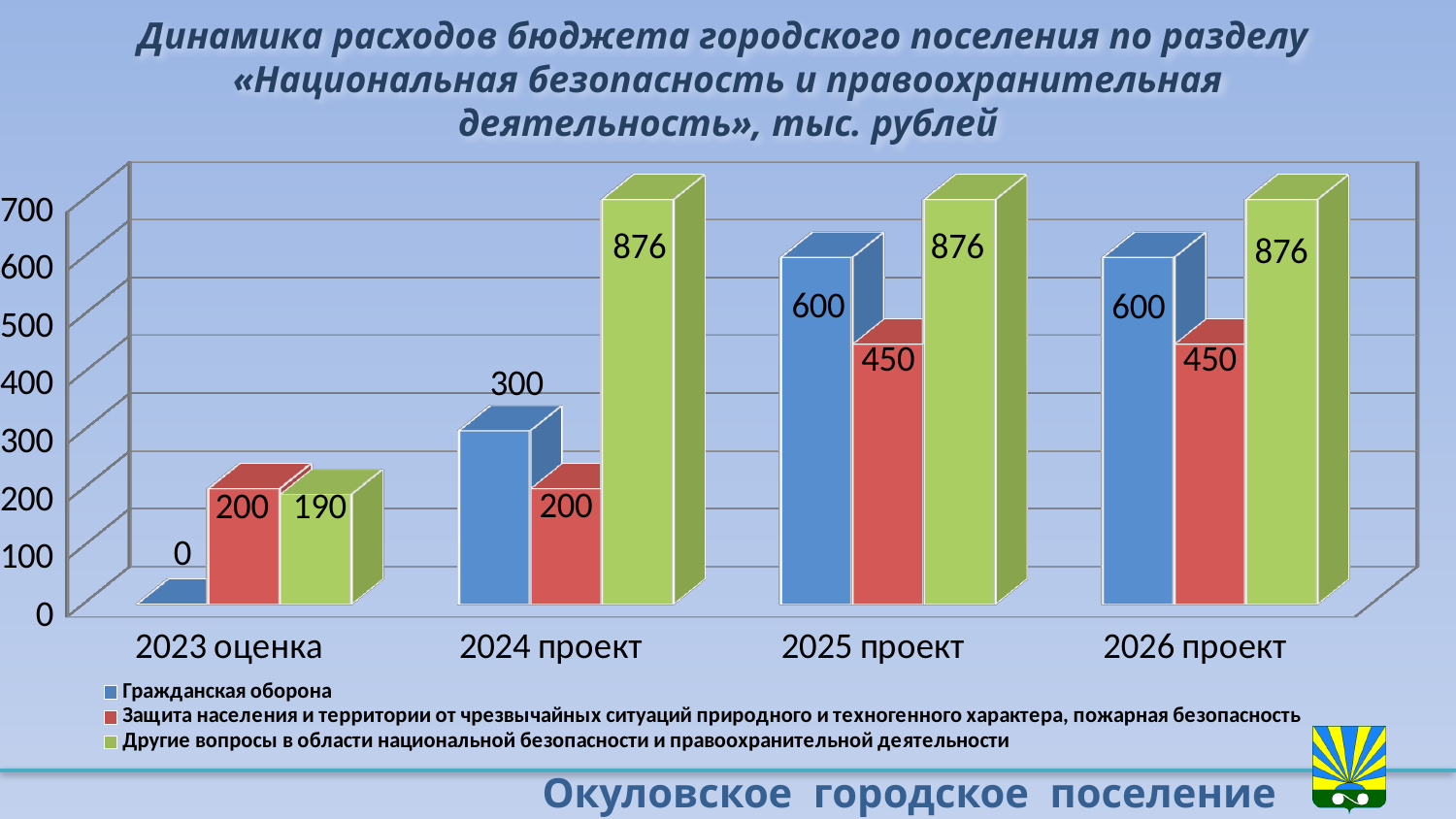
What is the difference between «Гражданская оборона» and «Защита населения...» in 2025 проект? 150 What is the difference between the «Другие вопросы...» value in 2024 проект and in 2023 оценка? 686 What is the value for «Защита населения и территории от чрезвычайных ситуаций природного и техногенного характера, пожарная безопасность» in 2025 проект? 450 Which is larger in 2024 проект: «Гражданская оборона» or «Защита населения...»? Гражданская оборона What is the value for «Другие вопросы в области национальной безопасности и правоохранительной деятельности» in 2023 оценка? 190 What is the value for «Гражданская оборона» in 2024 проект? 300 How many series does the legend list? 3 What kind of chart is shown on the slide? Bar chart In which year category is the value for «Гражданская оборона» lowest? 2023 оценка How many year categories are shown on the x axis? 4 What is the value for «Гражданская оборона» in 2023 оценка? 0 Which series has the highest value in 2026 проект? Другие вопросы в области национальной безопасности и правоохранительной деятельности